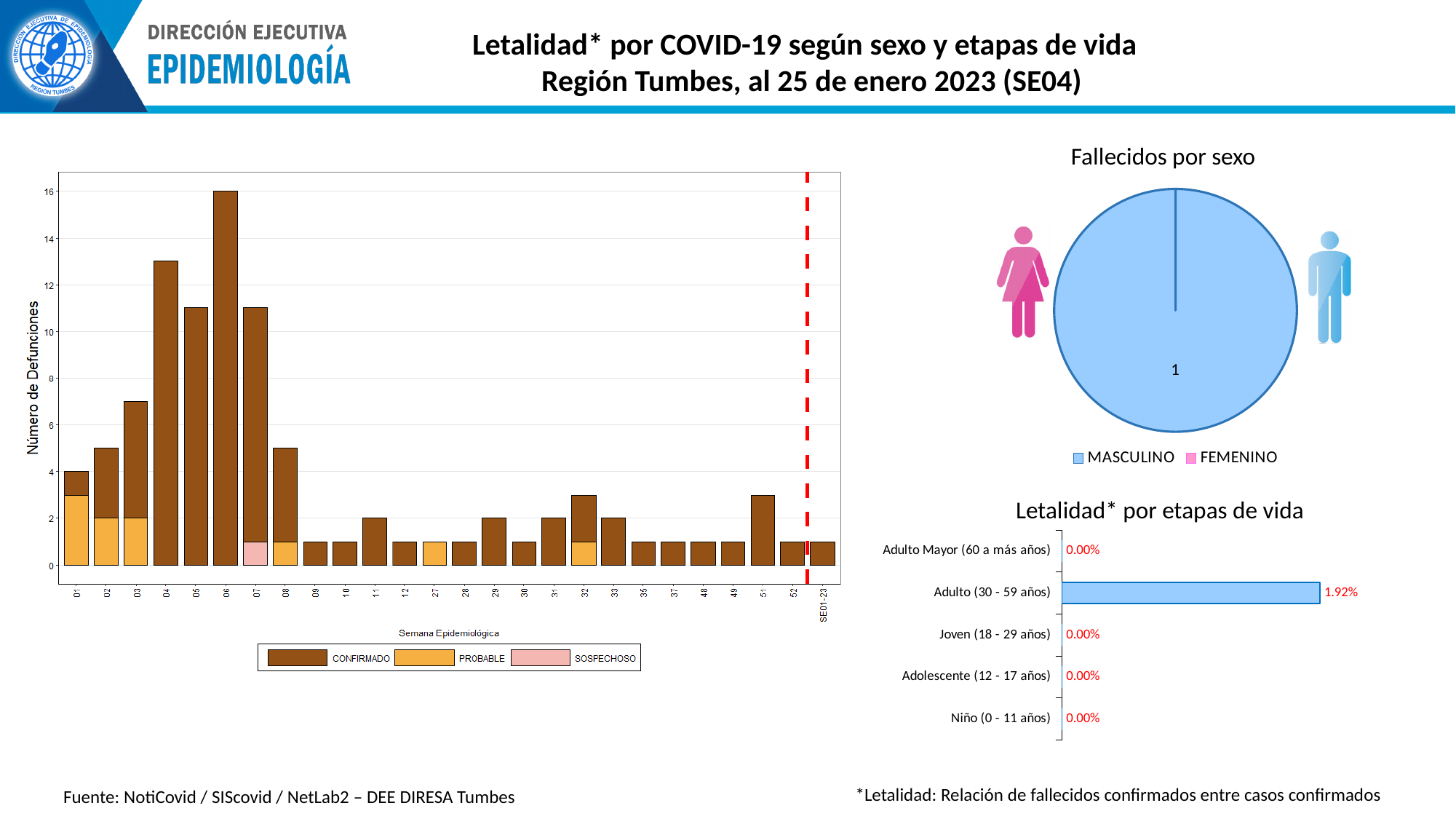
How many entries does the legend of the 'Fallecidos por sexo' chart list? 2 In the bar chart on the left (Número de Defunciones by Semana Epidemiológica), which week has the tallest bar? 06 How many age-group categories are shown in the 'Letalidad* por etapas de vida' chart? 5 What is the y-axis label of the bar chart on the left of the slide? Número de Defunciones What kind of chart is 'Fallecidos por sexo'? Pie chart How many series does the legend of the bar chart on the left (Número de Defunciones by Semana Epidemiológica) list? 3 What kind of chart is 'Letalidad* por etapas de vida'? Bar chart In the 'Fallecidos por sexo' chart, what value is printed on the MASCULINO slice? 1 In the bar chart on the left (Número de Defunciones by Semana Epidemiológica), is the total for week 04 greater or less than 12? greater In the 'Letalidad* por etapas de vida' chart, what is the value for Niño (0 - 11 años)? 0.00% In the 'Letalidad* por etapas de vida' chart, which age group has the highest value? Adulto (30 - 59 años) In the 'Letalidad* por etapas de vida' chart, what is the value for Adulto (30 - 59 años)? 1.92%